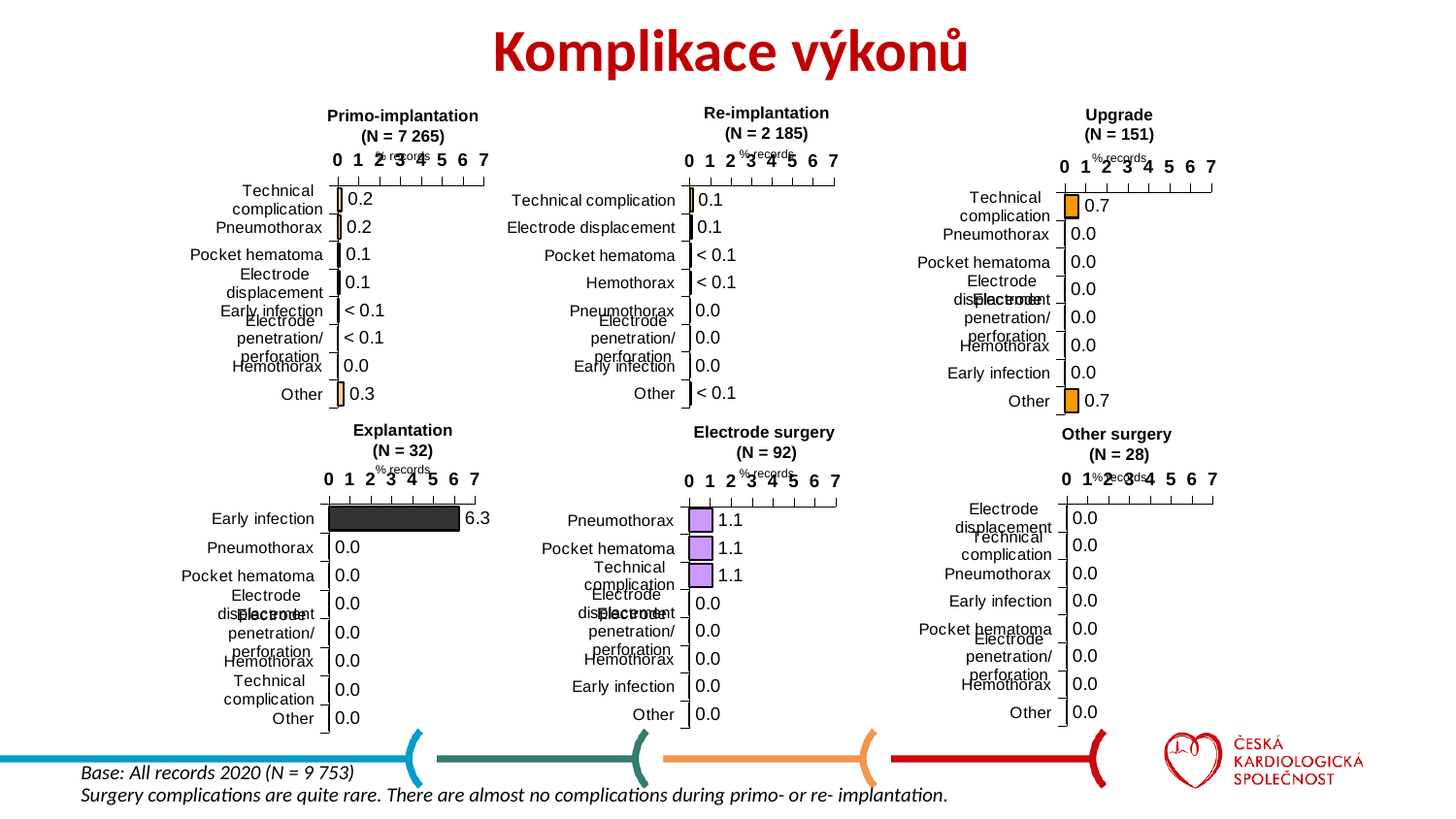
In the Explantation chart, which category has the highest value? Early infection In the Explantation chart, is the value for Early infection greater or less than 5? greater What kind of chart is the Electrode surgery chart? Bar chart In the Upgrade chart, what is the value for Technical complication? 0.7 In the Primo-implantation chart, what is the difference between the values for Other and Pocket hematoma? 0.2 In the Primo-implantation chart, what is the value for Other? 0.3 Which is larger: the value for Early infection in the Explantation chart or the value for Pneumothorax in the Electrode surgery chart? Early infection in the Explantation chart In the Primo-implantation chart, which category has the highest value? Other In the Electrode surgery chart, what is the value for Pocket hematoma? 1.1 In the Explantation chart, what is the value for Early infection? 6.3 How many categories are shown in the Upgrade chart? 8 In the Re-implantation chart, what is the value for Electrode displacement? 0.1